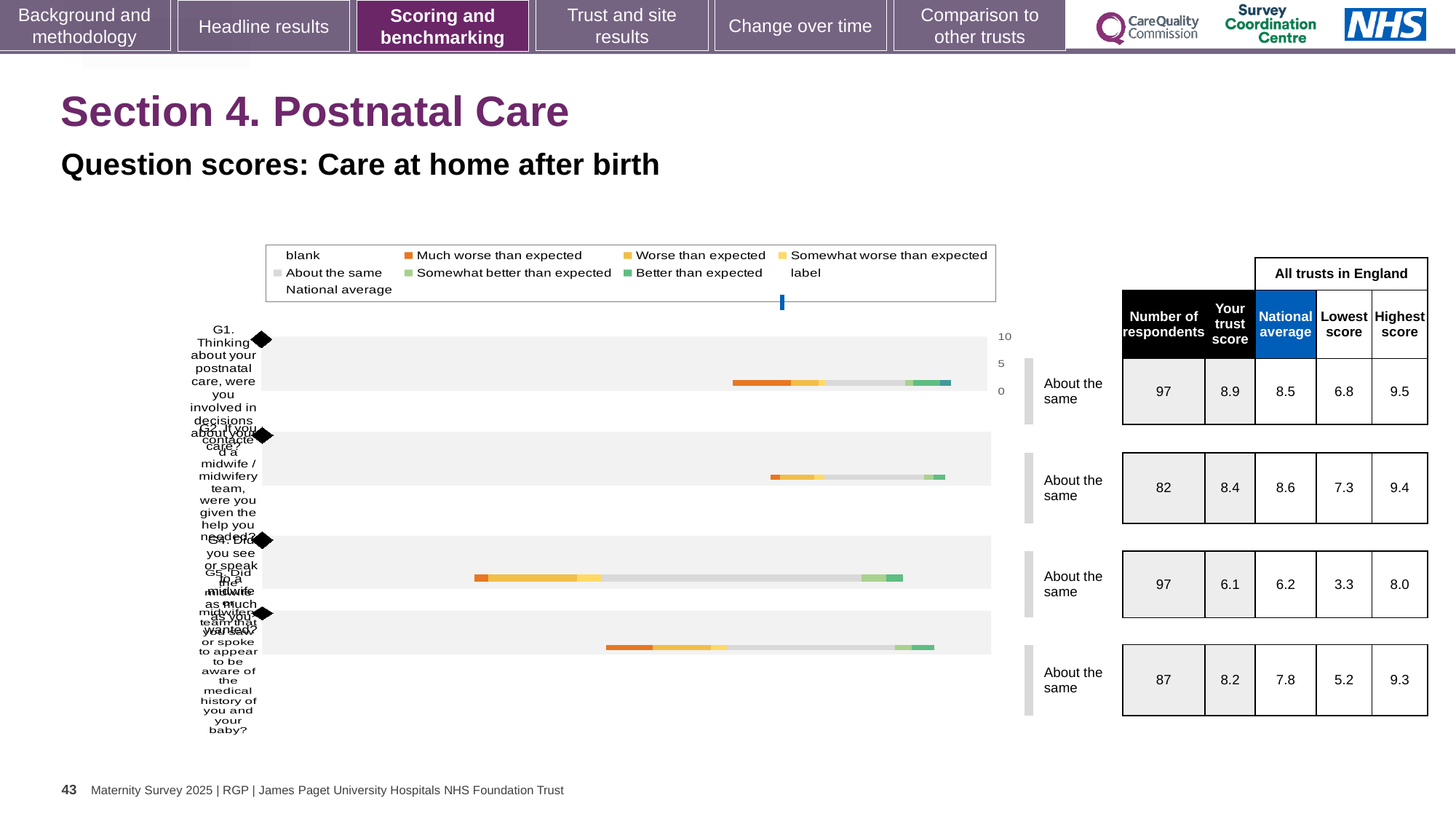
Which row has the lowest 'Your trust score'? the third row, 6.1 Which row has the highest 'Your trust score'? the first row (G1), 8.9 How many respondents are recorded for the fourth row? 87 For the first row (G1), what is the difference between the highest score and the lowest score across all trusts in England? 2.7 How many question bars are plotted in the chart? 4 What kind of chart is shown on the slide? bar chart What colour represents 'Much worse than expected' in the chart legend? orange What benchmark category is shown beside each of the four bars? About the same What is the 'Your trust score' for the first row (G1, involved in decisions about postnatal care)? 8.9 For the second row (G2), which is larger: the trust score or the national average? the national average (8.6) How many entries does the chart legend list? 9 What is the national average for the first row (G1)? 8.5